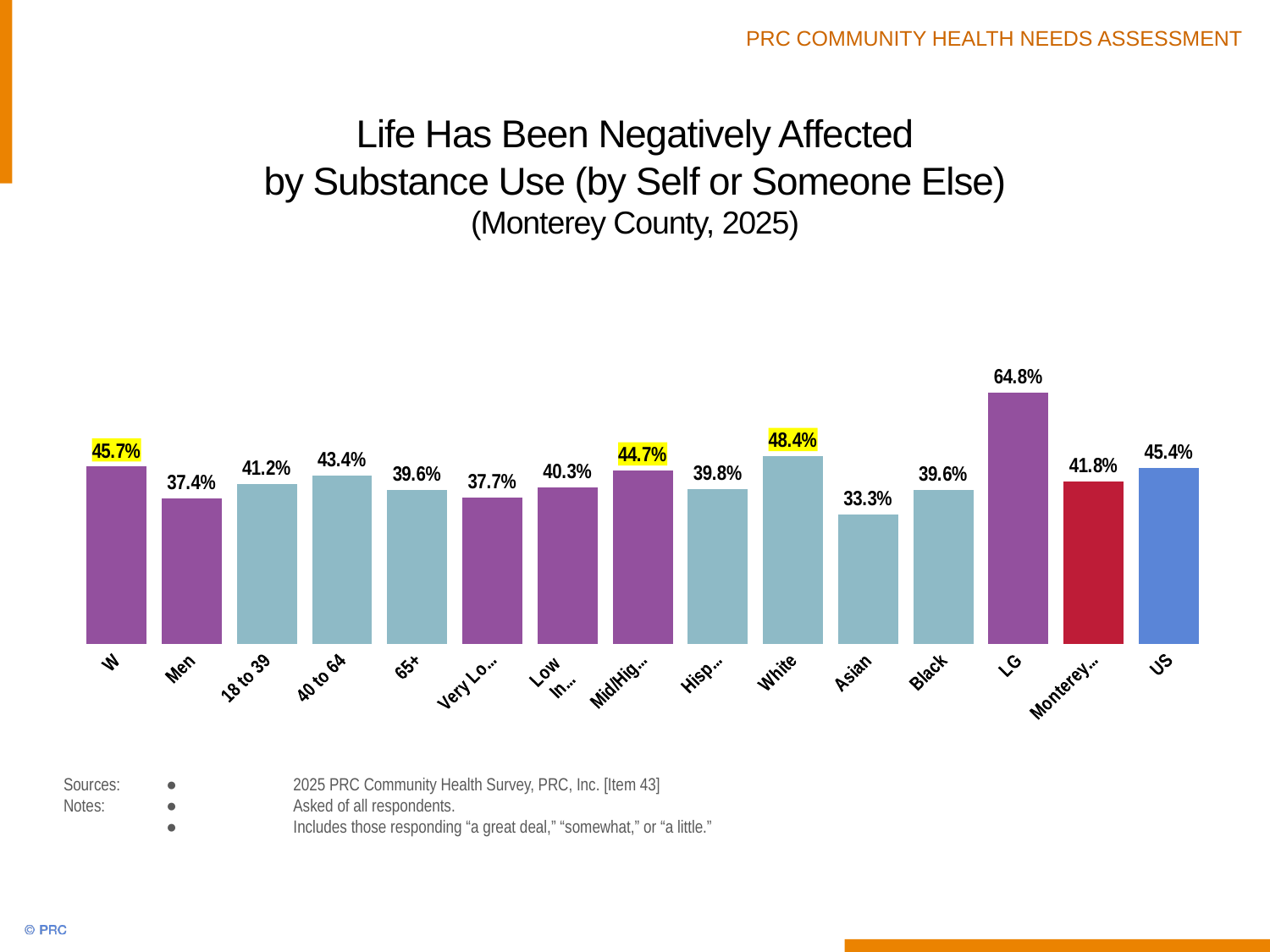
What kind of chart is shown on the slide? Bar chart What is the value for the 40 to 64 age group? 43.4% What is the value for US? 45.4% What is the value for the 65+ age group? 39.6% Which is larger, the value for 18 to 39 or for 40 to 64? 40 to 64 What is the value for White? 48.4% What is the value for Asian? 33.3% Which category has the lowest value? Asian What is the difference between the values for White and Asian? 15.1 percentage points What is the value for Men? 37.4% What is the difference between the values for US and Men? 8.0 percentage points How many bars are shown in the chart? 15